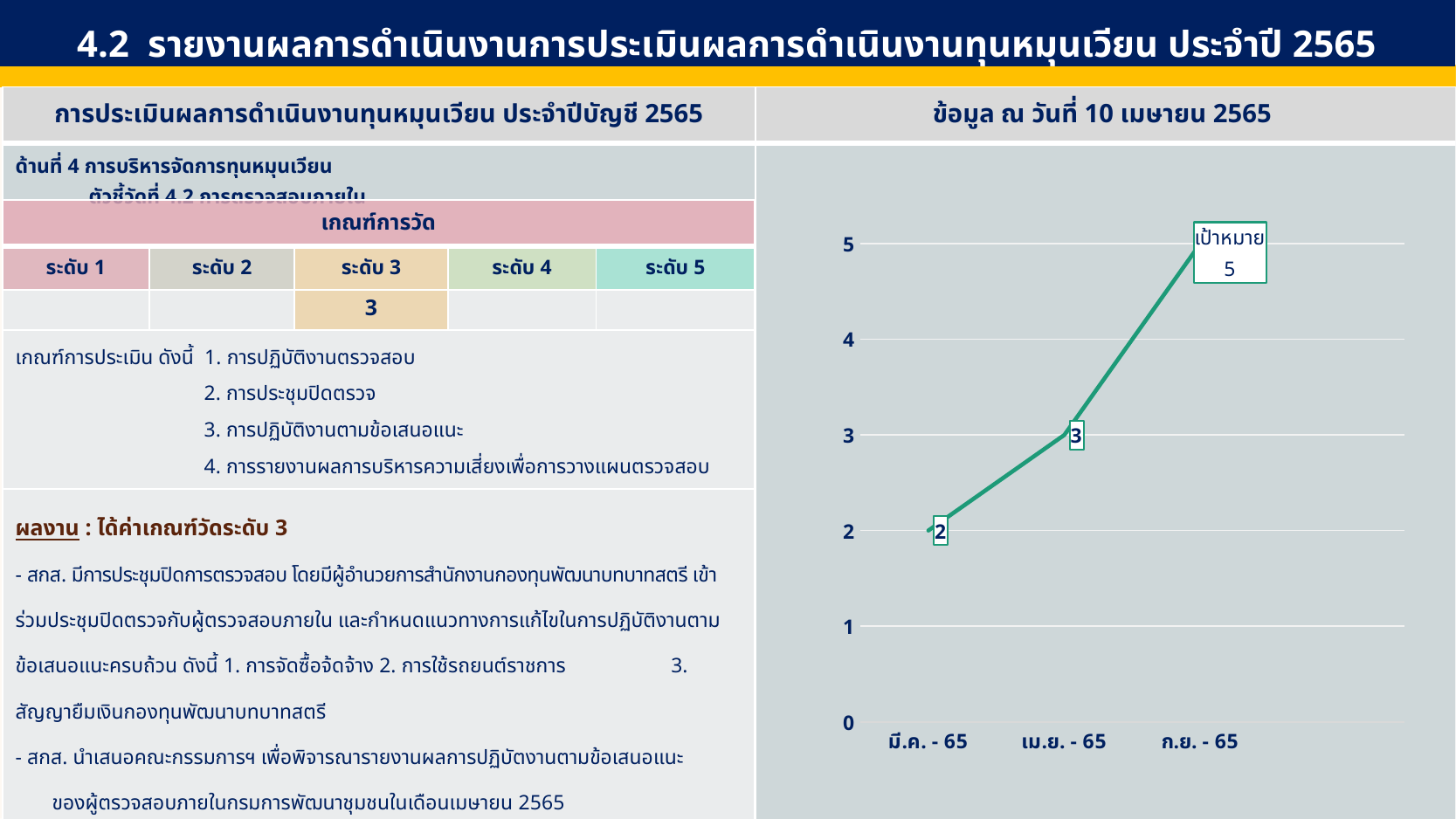
Which x-axis category has the highest value? ก.ย. - 65 What is the difference between the values for ก.ย. - 65 and มี.ค. - 65? 3 Which x-axis category has the lowest value? มี.ค. - 65 What is the value plotted for ก.ย. - 65? 5 What is the value plotted for มี.ค. - 65? 2 What type of chart is shown on the right side of the slide? line chart What is the difference between the values for เม.ย. - 65 and มี.ค. - 65? 1 What is the value plotted for เม.ย. - 65? 3 Which is larger, the value for เม.ย. - 65 or the value for มี.ค. - 65? เม.ย. - 65 How many data points are plotted on the line chart? 3 Do the values rise or fall from left to right along the x axis? rise What label is attached to the data point for ก.ย. - 65? เป้าหมาย 5